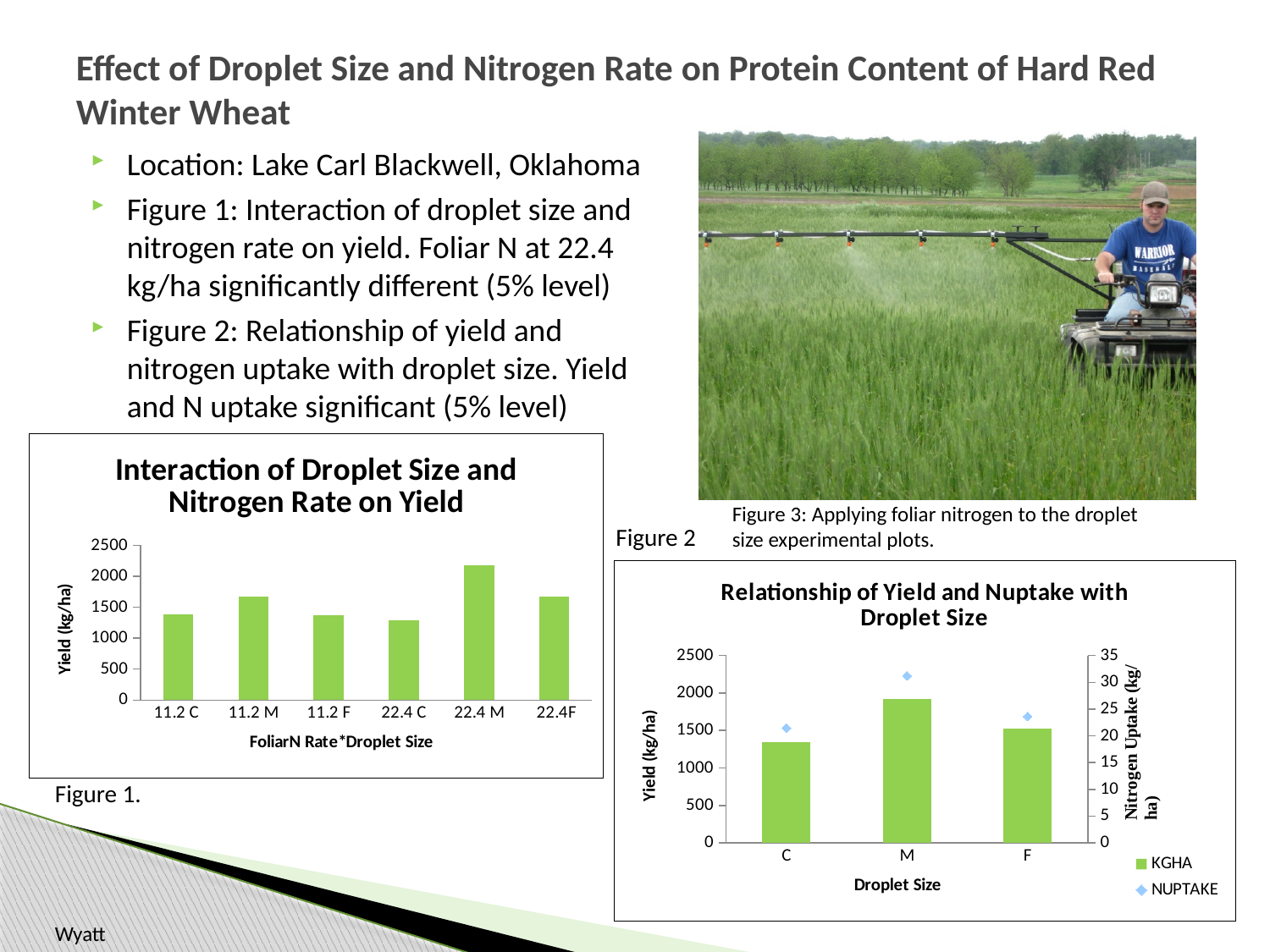
In the chart titled "Relationship of Yield and Nuptake with Droplet Size", which droplet size has the highest KGHA value? M In the chart titled "Relationship of Yield and Nuptake with Droplet Size", which droplet size has the lowest KGHA value? C What kind of chart is the chart titled "Interaction of Droplet Size and Nitrogen Rate on Yield"? bar chart In the chart titled "Relationship of Yield and Nuptake with Droplet Size", how many series does the legend list? 2 In the chart titled "Relationship of Yield and Nuptake with Droplet Size", is the NUPTAKE value for M greater or less than 30? greater In the chart titled "Interaction of Droplet Size and Nitrogen Rate on Yield", is the value for 22.4 C greater or less than 1500? less In the chart titled "Interaction of Droplet Size and Nitrogen Rate on Yield", is the value for 22.4 M greater or less than 2000? greater In the chart titled "Interaction of Droplet Size and Nitrogen Rate on Yield", how many categories are shown on the x axis? 6 In the chart titled "Interaction of Droplet Size and Nitrogen Rate on Yield", which is larger, the value for 11.2 M or the value for 11.2 F? 11.2 M In the chart titled "Interaction of Droplet Size and Nitrogen Rate on Yield", which category has the highest yield? 22.4 M In the chart titled "Interaction of Droplet Size and Nitrogen Rate on Yield", what is the x-axis title? FoliarN Rate*Droplet Size In the chart titled "Relationship of Yield and Nuptake with Droplet Size", what are the names of the two series in the legend? KGHA and NUPTAKE